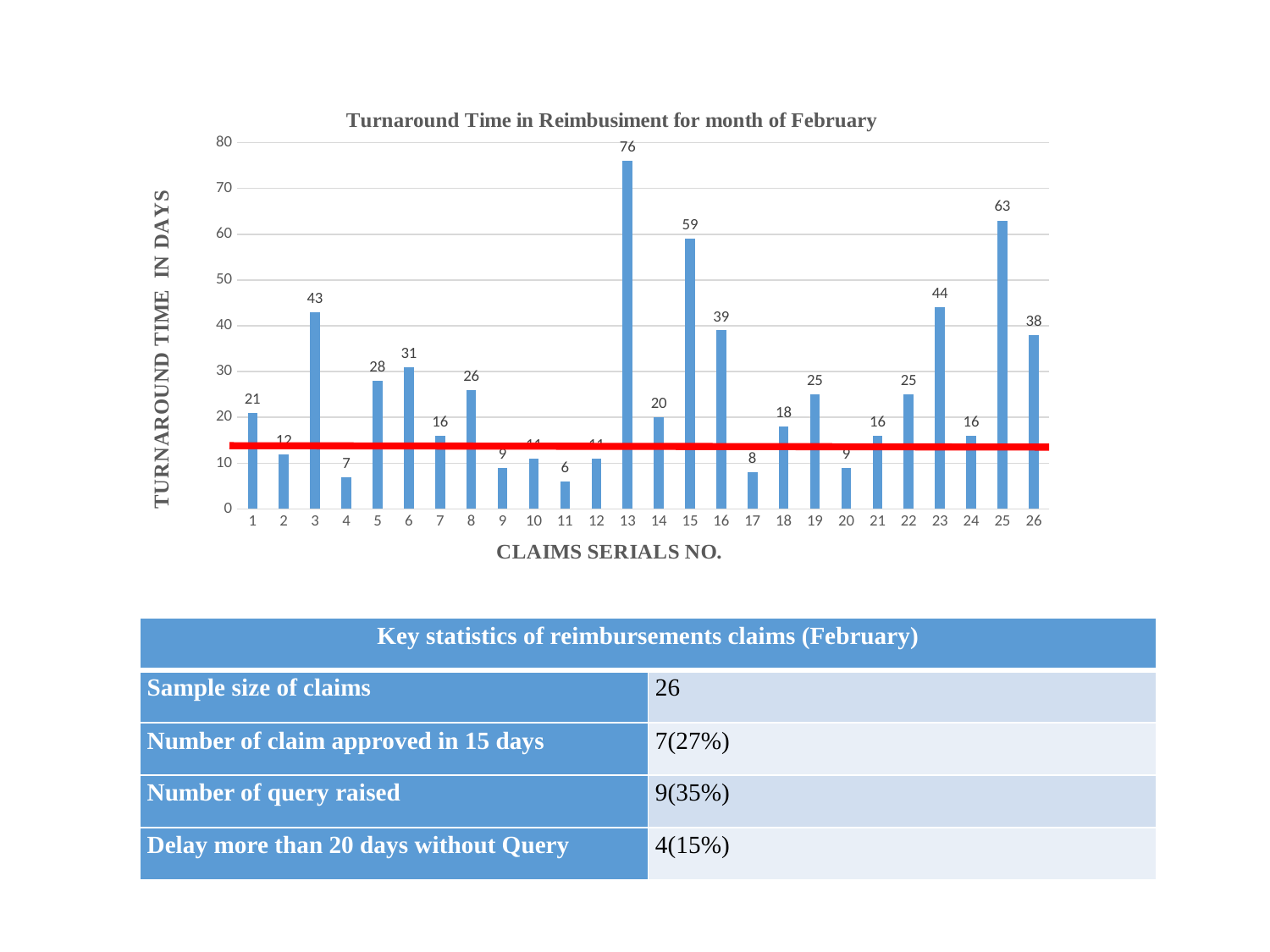
What is the turnaround time in days for claim serial no. 3? 43 What is the difference in turnaround time between claim serial no. 13 and claim serial no. 15? 17 Which claim serial no. has the highest turnaround time? 13 Which has a longer turnaround time, claim serial no. 16 or claim serial no. 23? Claim serial no. 23 What is the turnaround time in days for claim serial no. 25? 63 How many claim serial numbers are plotted on the chart? 26 What is the difference in turnaround time between claim serial no. 25 and claim serial no. 26? 25 What is the turnaround time in days for claim serial no. 13? 76 Which claim serial no. has the lowest turnaround time? 11 What type of chart is used to show turnaround time in reimbursement for February? Bar chart What is the title of the chart? Turnaround Time in Reimbusiment for month of February Is the turnaround time for claim serial no. 15 greater or less than 50 days? greater